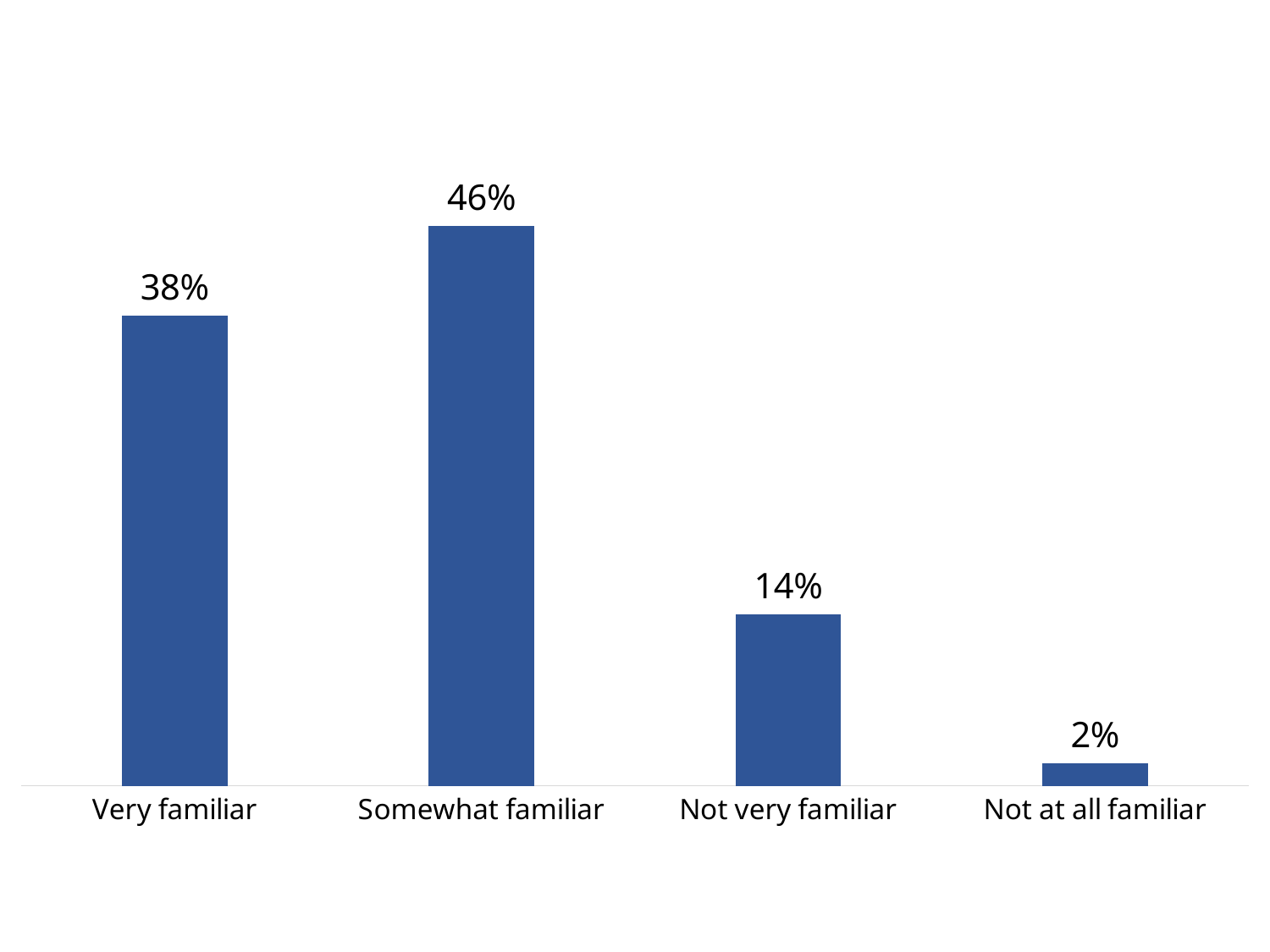
Which category has the lowest value? Not at all familiar What is the value for Somewhat familiar? 46% What kind of chart is this? Bar chart What colour are the bars on the chart? Blue What is the value for Not at all familiar? 2% What is the value for Not very familiar? 14% What is the difference between the values for Somewhat familiar and Very familiar? 8% What is the value for Very familiar? 38% What is the difference between the values for Not very familiar and Not at all familiar? 12% Which is larger, the value for Very familiar or the value for Not very familiar? Very familiar How many categories are shown on the chart? 4 Which category has the highest value? Somewhat familiar